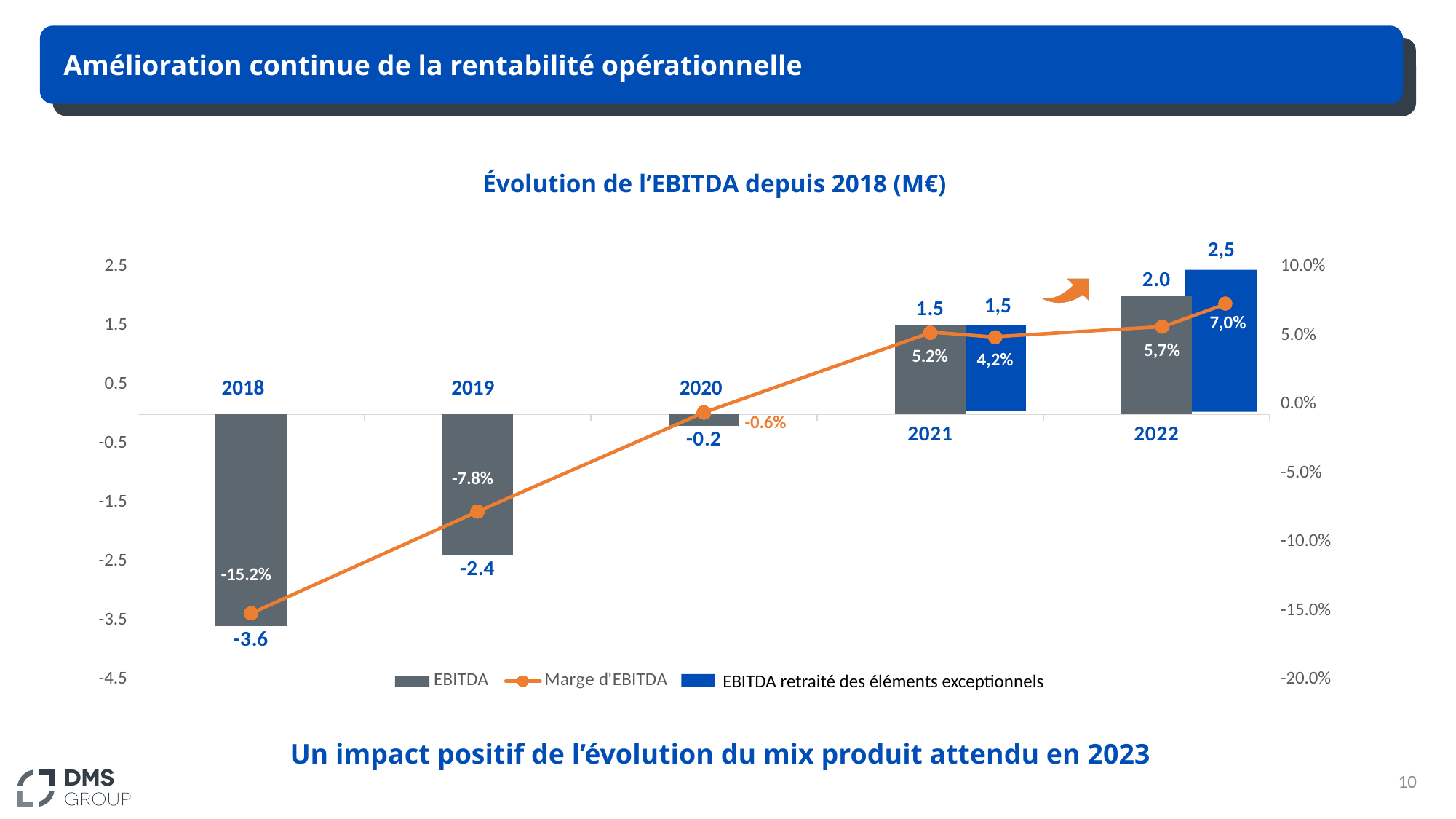
What is the title of the chart? Évolution de l'EBITDA depuis 2018 (M€) What is the Marge d'EBITDA for 2019? -7.8% Which is larger: the EBITDA for 2019 or the EBITDA for 2020? 2020 Does the Marge d'EBITDA rise or fall from 2018 to 2022? rise What is the value of 'EBITDA retraité des éléments exceptionnels' for 2022? 2,5 How many series does the legend list? 3 Which year has the lowest EBITDA? 2018 What is the Marge d'EBITDA shown on the 2021 EBITDA bar? 5.2% What is the difference between the EBITDA for 2022 and the EBITDA for 2021? 0.5 What is the EBITDA value for 2022? 2.0 What is the EBITDA value for 2018? -3.6 Which year has the highest EBITDA (grey bars)? 2022